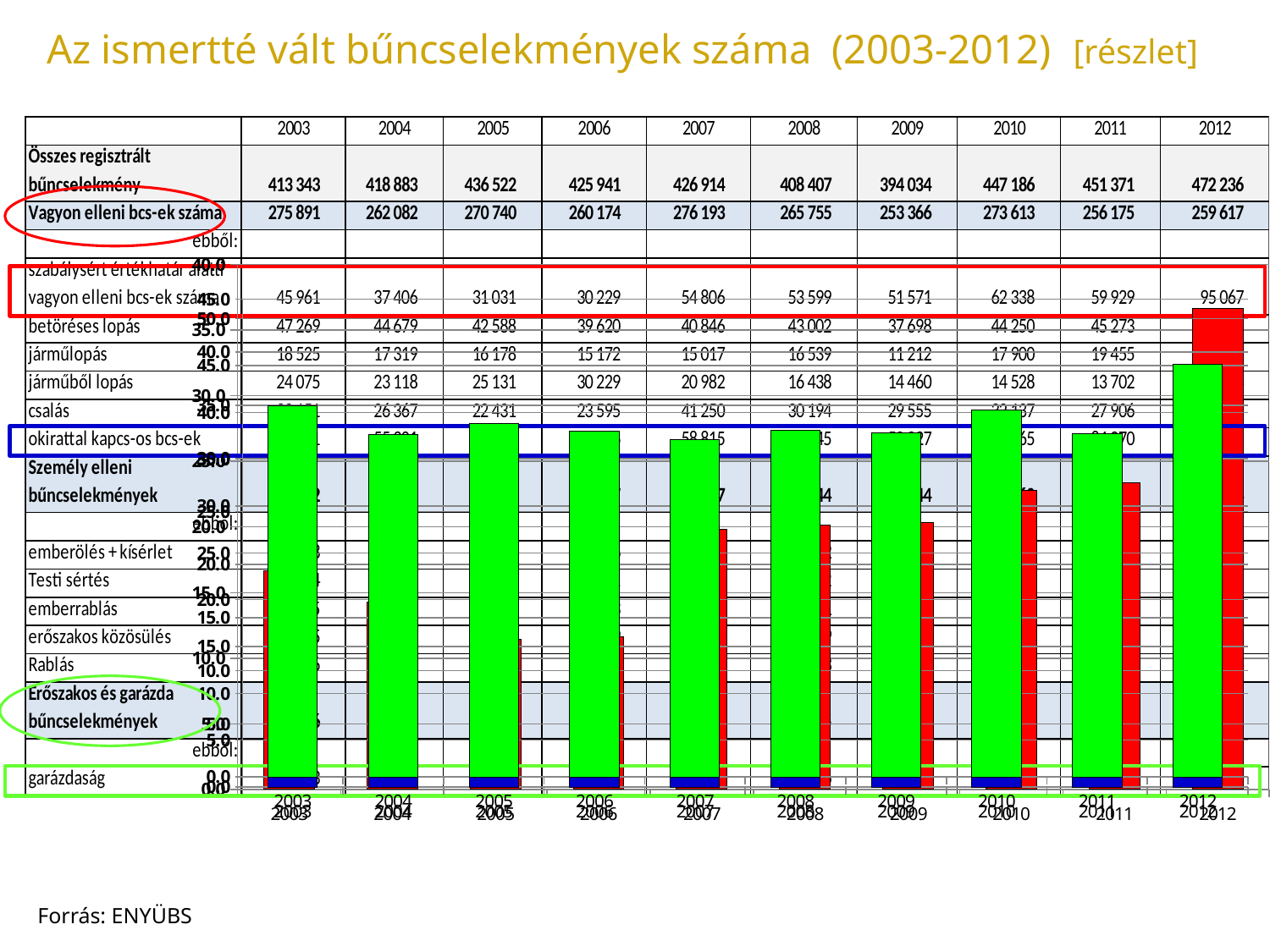
Is the red bar taller in 2012 or in 2003? 2012 In which year is the green bar the tallest? 2012 Is the red bar taller in 2003 or in 2006? 2003 What is the last year shown on the x axis of the chart? 2012 Is the green bar taller in 2012 or in 2011? 2012 What kind of chart is shown on the slide? bar chart In which year is the red bar the tallest? 2012 How many years are shown along the x axis of the chart? 10 What is the first year shown on the x axis of the chart? 2003